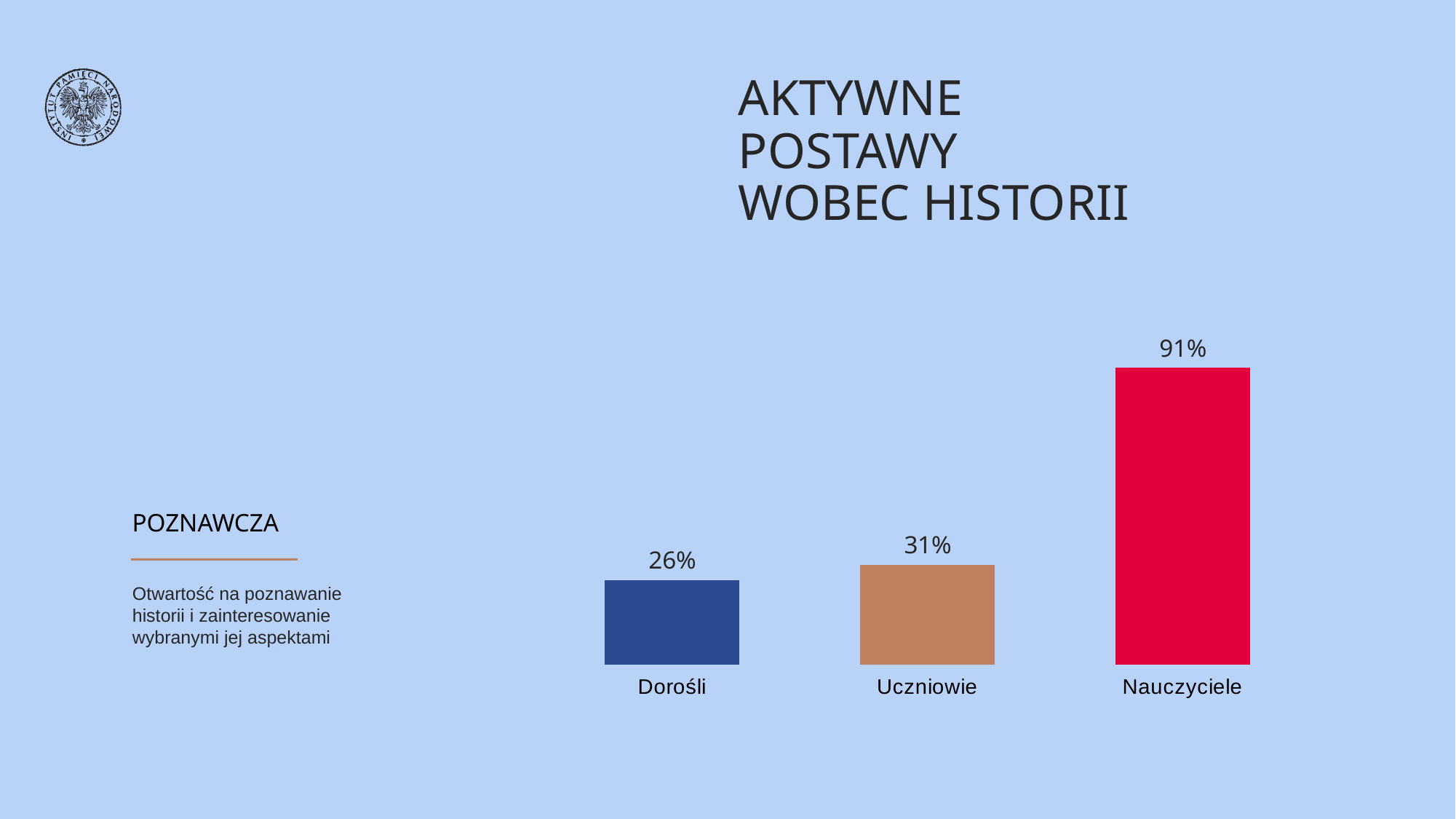
What is the value for Uczniowie? 31% Which category has the highest value? Nauczyciele What is the value for Nauczyciele? 91% What is the value for Dorośli? 26% Which is larger, the value for Uczniowie or the value for Dorośli? Uczniowie What is the difference between the values for Uczniowie and Dorośli? 5% Do the values rise or fall from left to right across the categories? Rise How many categories are shown in the chart? 3 What is the difference between the values for Nauczyciele and Dorośli? 65% What colour is the bar for Nauczyciele? Red Which category has the lowest value? Dorośli What kind of chart is shown on the slide? Bar chart